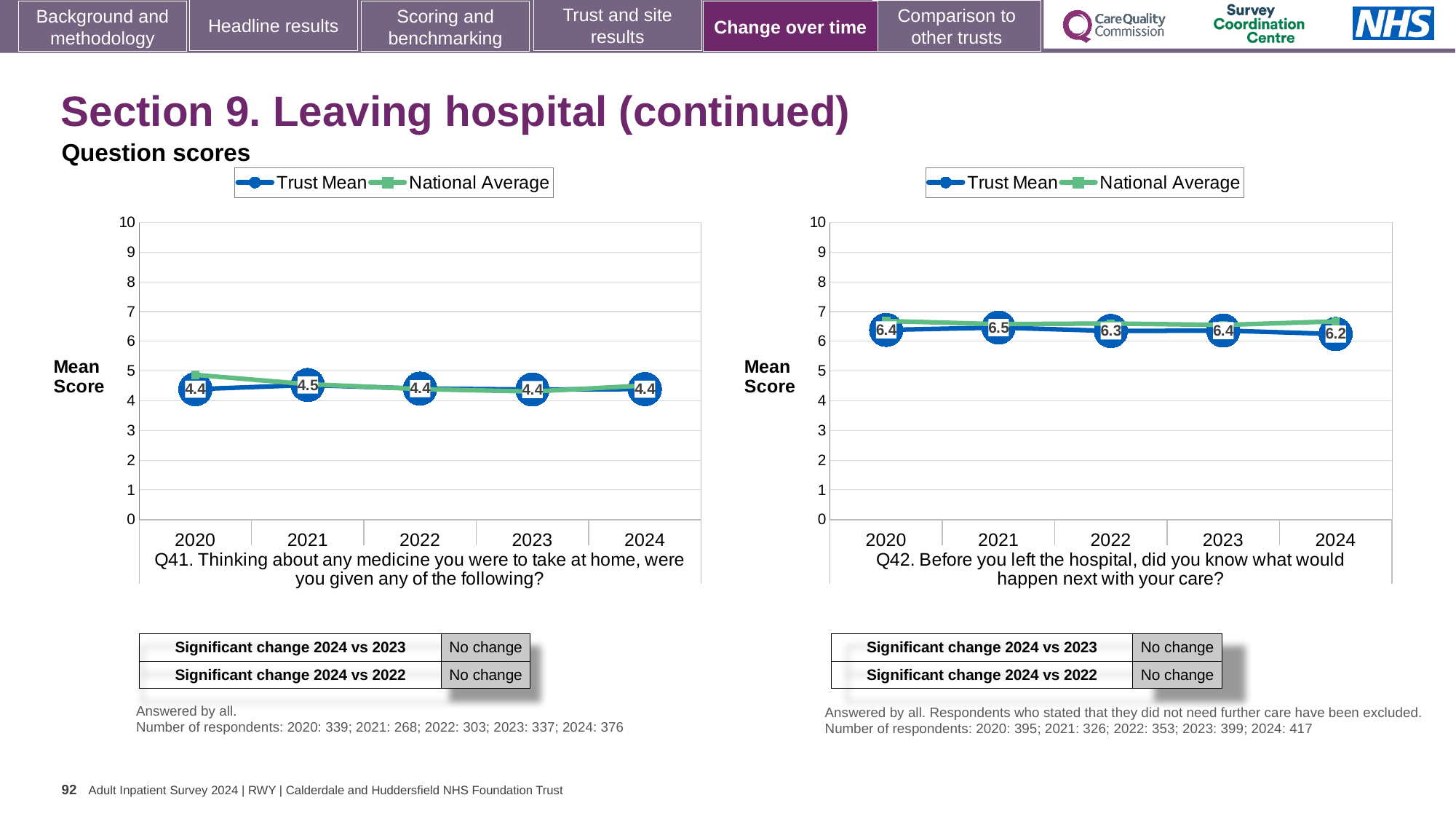
In the Q42 chart, which year has the lowest Trust Mean score? 2024 In the Q42 chart, what is the difference between the Trust Mean scores for 2021 and 2024? 0.3 How many series does the legend of the Q42 chart list? 2 In the Q42 chart, what is the Trust Mean score for 2022? 6.3 How many years are plotted on the x axis of the Q41 chart? 5 In the Q41 chart, is the National Average value for 2020 greater or less than 4? greater What kind of chart is the Q42 chart? Line chart In the Q41 chart, what is the Trust Mean score for 2021? 4.5 In the Q41 chart, what is the Trust Mean score for 2024? 4.4 In the Q42 chart, does the Trust Mean score rise or fall from 2023 to 2024? Fall In the Q42 chart, which year has the highest Trust Mean score? 2021 In the Q42 chart, is the Trust Mean score higher in 2020 or in 2024? 2020